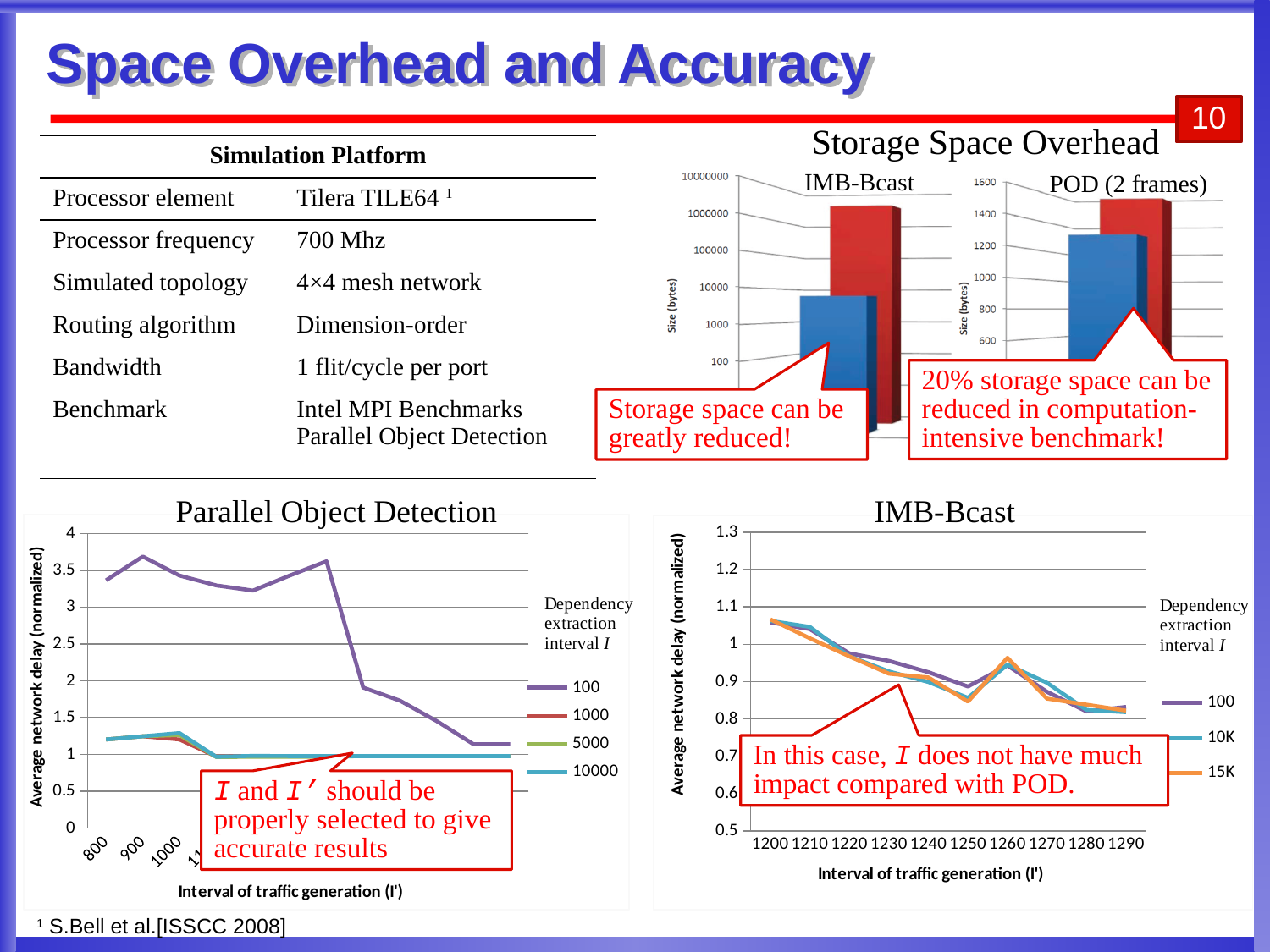
What kind of chart is the Storage Space Overhead IMB-Bcast chart at the top right? bar chart How many x-axis points are shown on the IMB-Bcast line chart at the bottom right? 10 In the Parallel Object Detection chart, which series has the highest values, 100 or 10000? 100 In the IMB-Bcast line chart at the bottom right, do the values of the 100 series generally rise or fall as the interval increases from 1200 to 1290? fall What is the x-axis title of the IMB-Bcast line chart at the bottom right? Interval of traffic generation (I') How many series does the legend of the IMB-Bcast line chart at the bottom right list? 3 In the Storage Space Overhead POD (2 frames) bar chart, is the blue bar greater or less than 1000 bytes? greater In the Parallel Object Detection chart, is the value of the 100 series at interval 900 greater or less than 3.5? greater In the IMB-Bcast line chart at the bottom right, is the value of the 100 series at interval 1200 greater or less than 1? greater How many series does the legend of the Parallel Object Detection chart list? 4 What kind of chart is the Parallel Object Detection chart at the bottom left? line chart